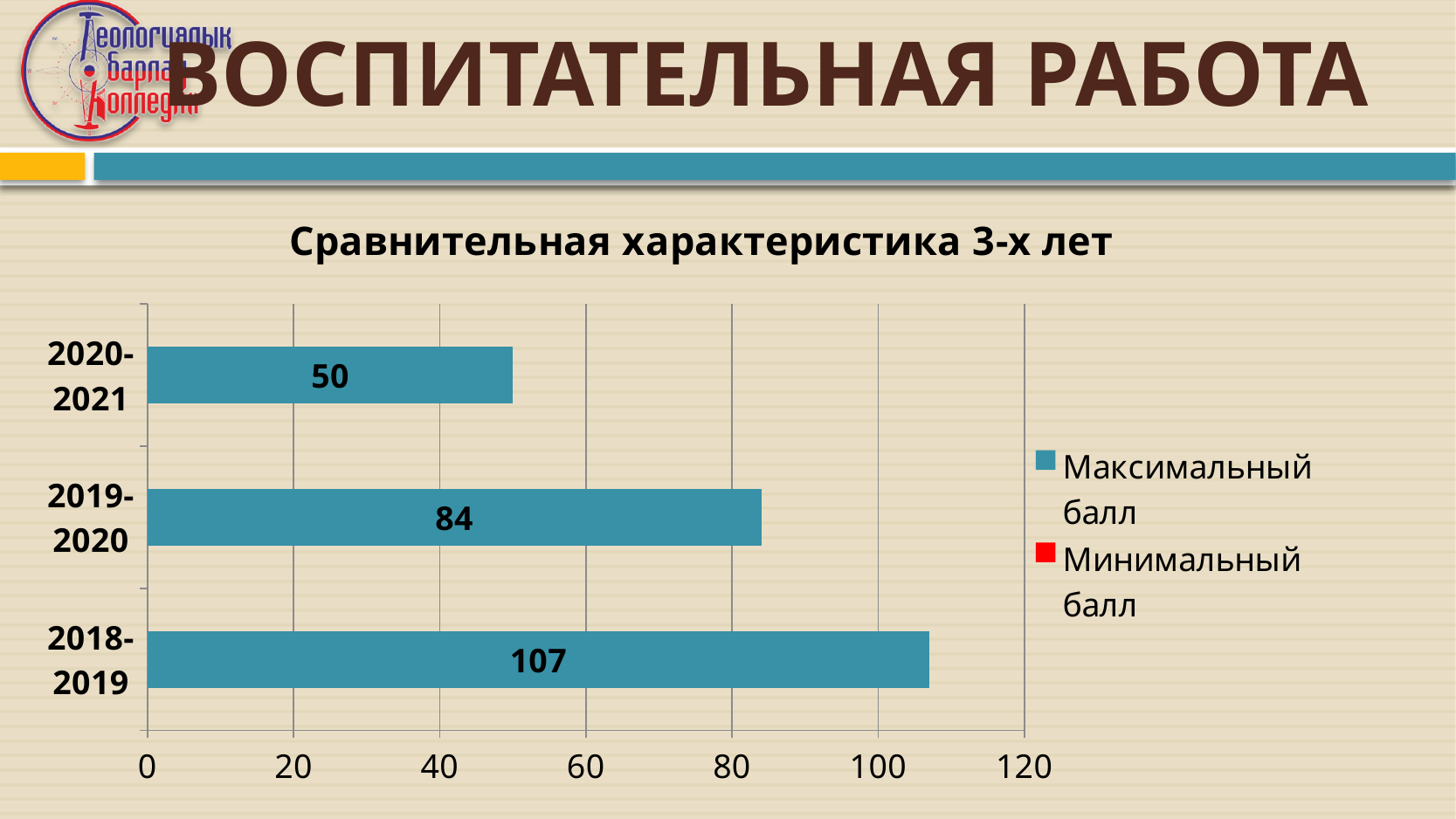
What kind of chart is shown on the slide? Bar chart How many series does the legend list? 2 What is the difference between the Максимальный балл for 2019-2020 and 2020-2021? 34 What is the difference between the Максимальный балл for 2018-2019 and 2020-2021? 57 How many academic years are shown on the chart? 3 Is the value for 2019-2020 greater or less than 80? greater What is the value of Максимальный балл for 2020-2021? 50 Which is larger, the Максимальный балл for 2019-2020 or for 2020-2021? 2019-2020 Which academic year has the highest Максимальный балл? 2018-2019 Which academic year has the lowest Максимальный балл? 2020-2021 What is the value of Максимальный балл for 2019-2020? 84 What is the value of Максимальный балл for 2018-2019? 107